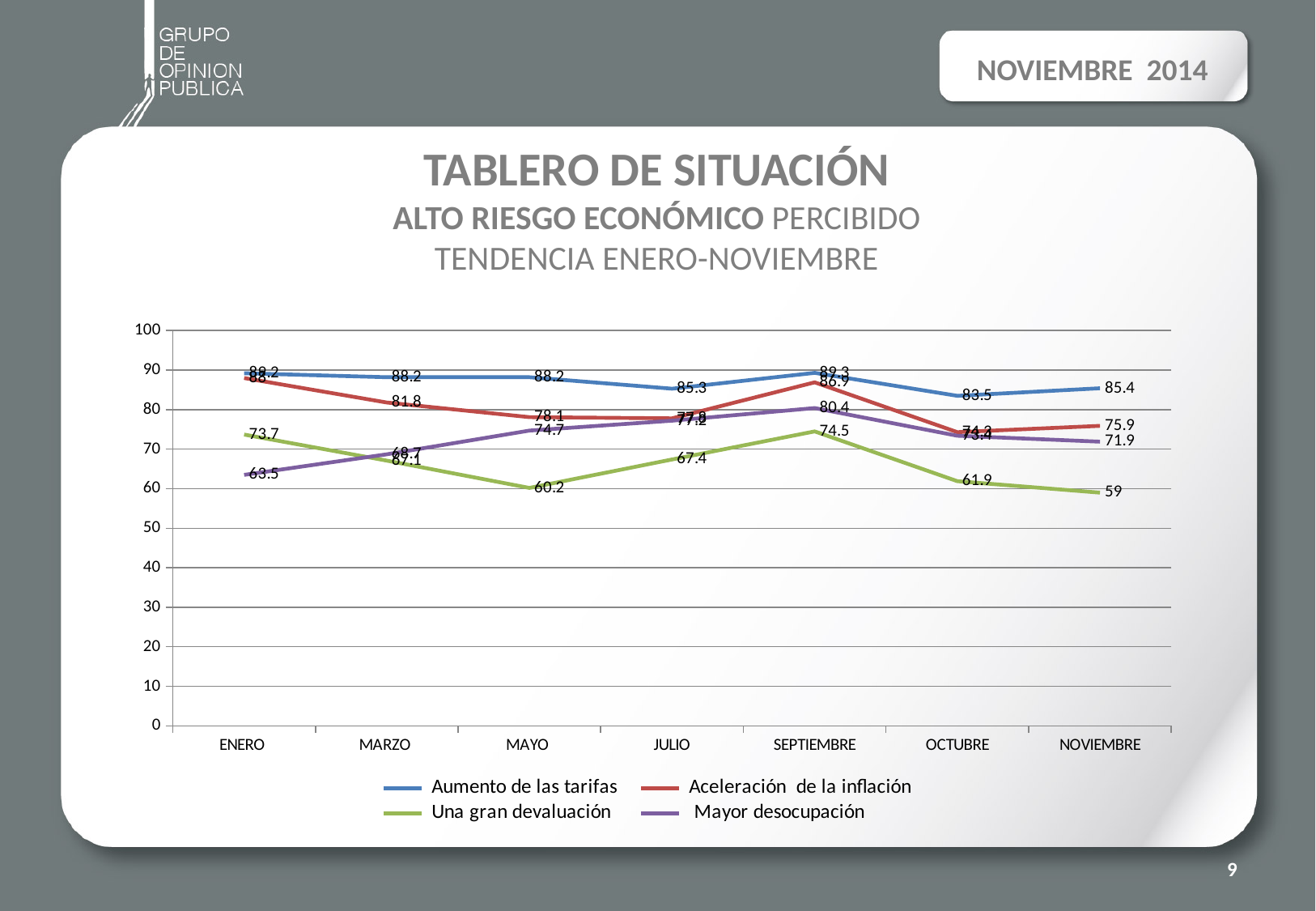
What kind of chart is shown on the slide? Line chart In which month is Una gran devaluación at its lowest? NOVIEMBRE What is the value for Una gran devaluación in NOVIEMBRE? 59 How many months are shown on the x axis? 7 In SEPTIEMBRE, which is larger: Aceleración de la inflación or Mayor desocupación? Aceleración de la inflación In which month is Aumento de las tarifas at its highest? SEPTIEMBRE What is the value for Aumento de las tarifas in SEPTIEMBRE? 89.3 Does Mayor desocupación rise or fall from ENERO to SEPTIEMBRE? Rises In NOVIEMBRE, what is the difference between Aumento de las tarifas and Una gran devaluación? 26.4 What is the value for Aceleración de la inflación in NOVIEMBRE? 75.9 How many series does the legend list? 4 What is the value for Mayor desocupación in ENERO? 63.5